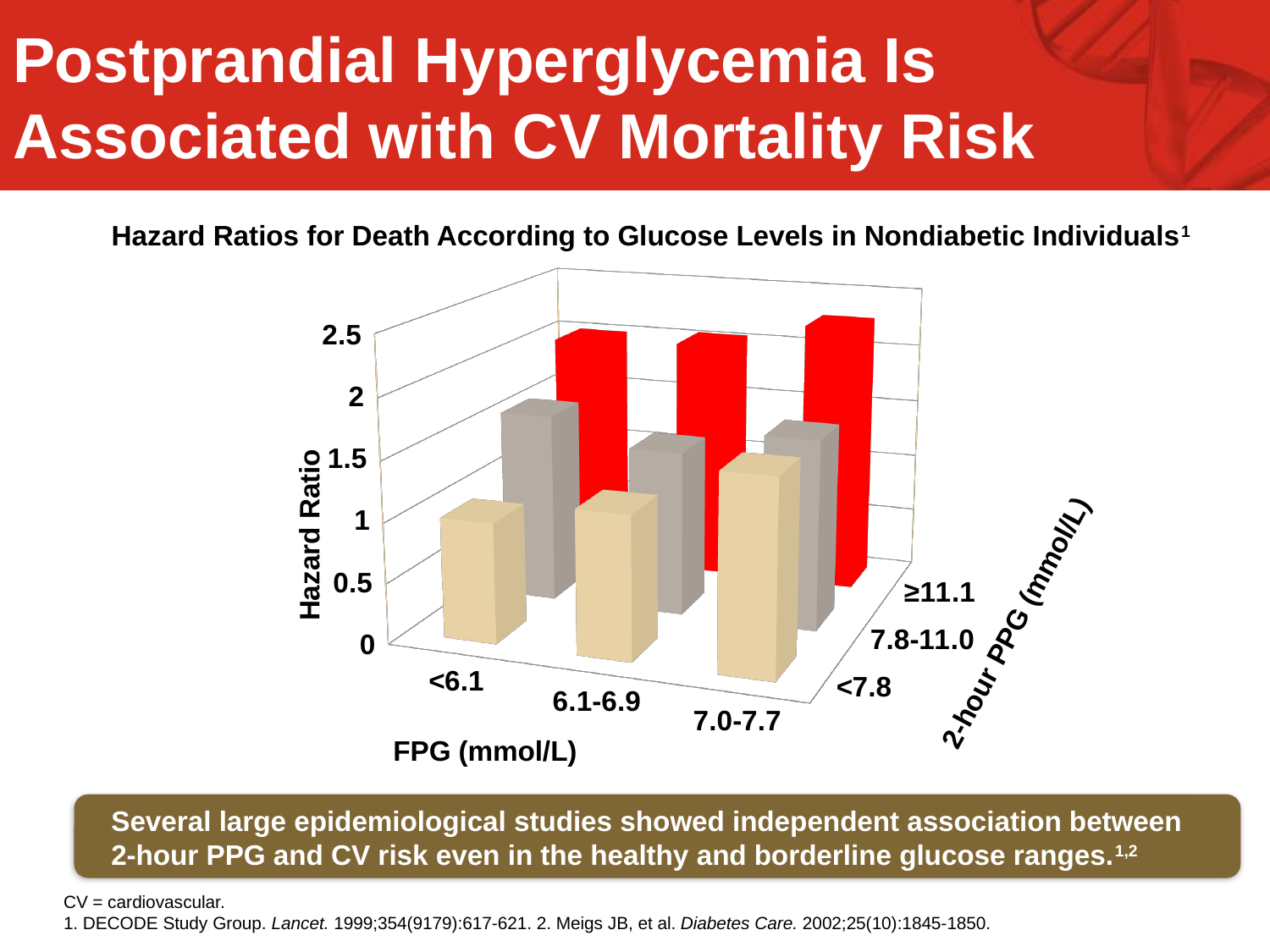
How many 2-hour PPG (mmol/L) categories are shown on the chart? 3 What is the title of the vertical axis of the chart? Hazard Ratio How many bars are plotted in total on the chart? 9 Is the hazard ratio for FPG <6.1 and 2-hour PPG <7.8 greater or less than 1.5? less Within each FPG group, does the hazard ratio rise or fall as 2-hour PPG increases from <7.8 to ≥11.1? rise How many FPG (mmol/L) categories are shown on the chart? 3 For FPG <6.1, which has the larger hazard ratio: 2-hour PPG ≥11.1 or 2-hour PPG <7.8? 2-hour PPG ≥11.1 What kind of chart is shown on the slide? bar chart Which 2-hour PPG category has the highest hazard ratios across all FPG groups? ≥11.1 Is the hazard ratio for FPG <6.1 and 2-hour PPG ≥11.1 greater or less than 1? greater For FPG 6.1-6.9, which has the larger hazard ratio: 2-hour PPG 7.8-11.0 or 2-hour PPG <7.8? 2-hour PPG 7.8-11.0